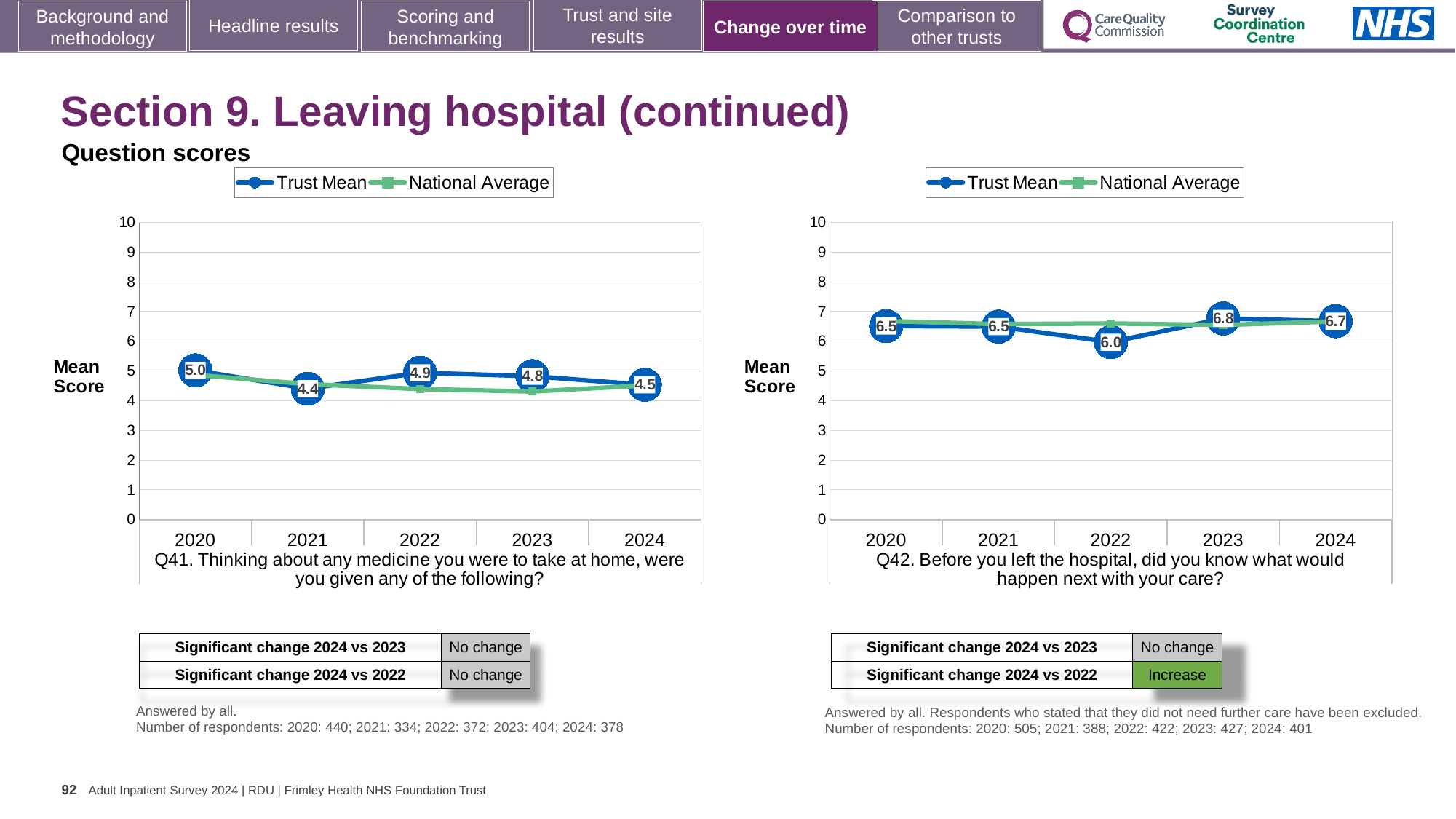
How many years are plotted on the Q42 chart? 5 On the Q42 chart, what is the difference between the Trust Mean scores for 2023 and 2022? 0.8 On the Q41 chart, what is the Trust Mean score for 2020? 5.0 How many series does the legend of the Q41 chart list? 2 On the Q42 chart, which year has the highest Trust Mean score? 2023 On the Q42 chart, which is larger, the Trust Mean score for 2022 or for 2023? 2023 On the Q41 chart, is the Trust Mean score for 2022 greater or less than 4? greater What kind of chart is the Q41 chart? Line chart On the Q41 chart, which year has the lowest Trust Mean score? 2021 On the Q41 chart, what is the Trust Mean score for 2024? 4.5 On the Q41 chart, what is the difference between the Trust Mean scores for 2020 and 2021? 0.6 On the Q42 chart, what is the Trust Mean score for 2022? 6.0